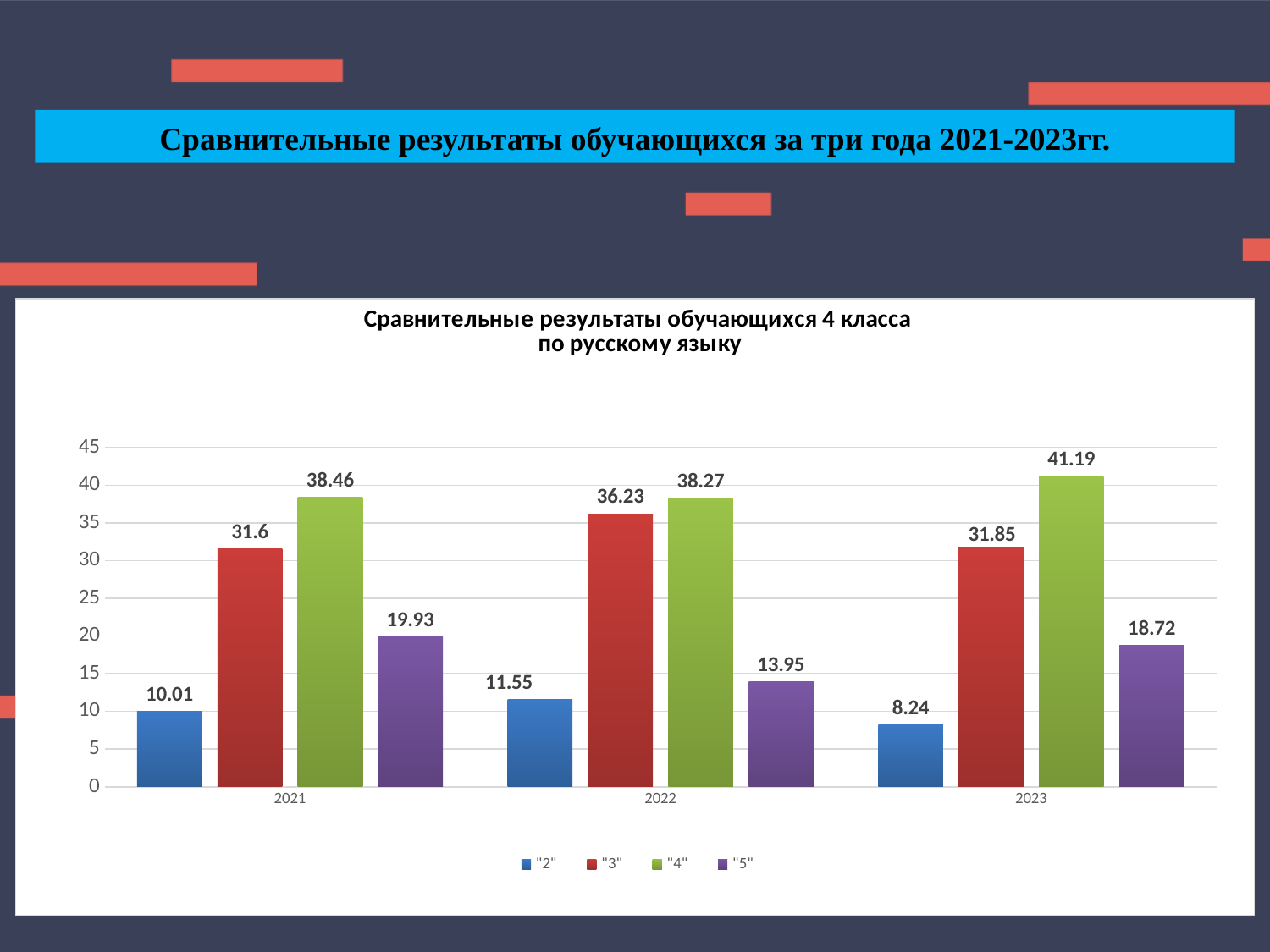
Which year has the highest value for series "3"? 2022 Which year has the lowest value for series "2"? 2023 What is the title of the chart? Сравнительные результаты обучающихся 4 класса по русскому языку What kind of chart is shown on the slide? bar chart How many years are shown on the x axis? 3 Is the value for series "3" in 2022 greater or less than 35? greater What is the value for series "4" in 2023? 41.19 How many series does the legend list? 4 Which is larger: the value for series "5" in 2021 or in 2023? 2021 What is the value for series "2" in 2021? 10.01 What is the difference between the values for series "4" and series "3" in 2021? 6.86 What is the value for series "5" in 2022? 13.95